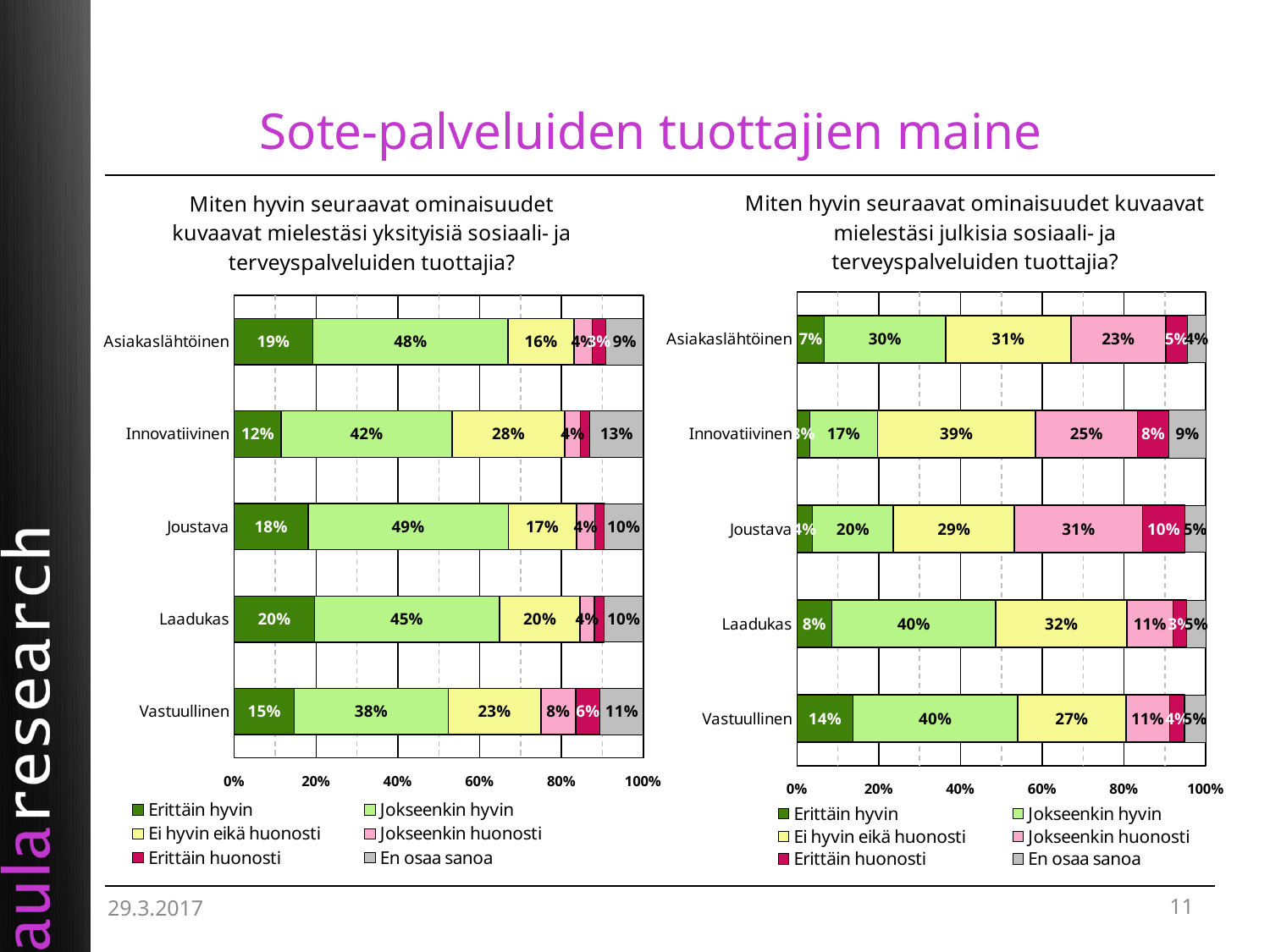
In the left chart (private providers), what percentage of respondents said 'Erittäin hyvin' for Laadukas? 20% How many categories are shown in the right chart (public providers)? 5 In the right chart (public providers), what is the 'Jokseenkin hyvin' value for Vastuullinen? 40% In the left chart (private providers), what is the 'Ei hyvin eikä huonosti' value for Innovatiivinen? 28% In the left chart (private providers), what is the difference between the 'Jokseenkin hyvin' values for Joustava and Vastuullinen? 11 percentage points What type of chart is used on the left side of the slide? Stacked bar chart In the right chart (public providers), what is the 'Jokseenkin huonosti' value for Joustava? 31% In the right chart (public providers), which category has the lowest 'Erittäin hyvin' value? Innovatiivinen What is the title of the slide? Sote-palveluiden tuottajien maine How many series does the legend of the left chart (private providers) list? 6 In the right chart (public providers), which is larger: the 'Erittäin hyvin' value for Vastuullinen or for Laadukas? Vastuullinen In the left chart (private providers), which category has the highest 'Jokseenkin hyvin' value? Joustava